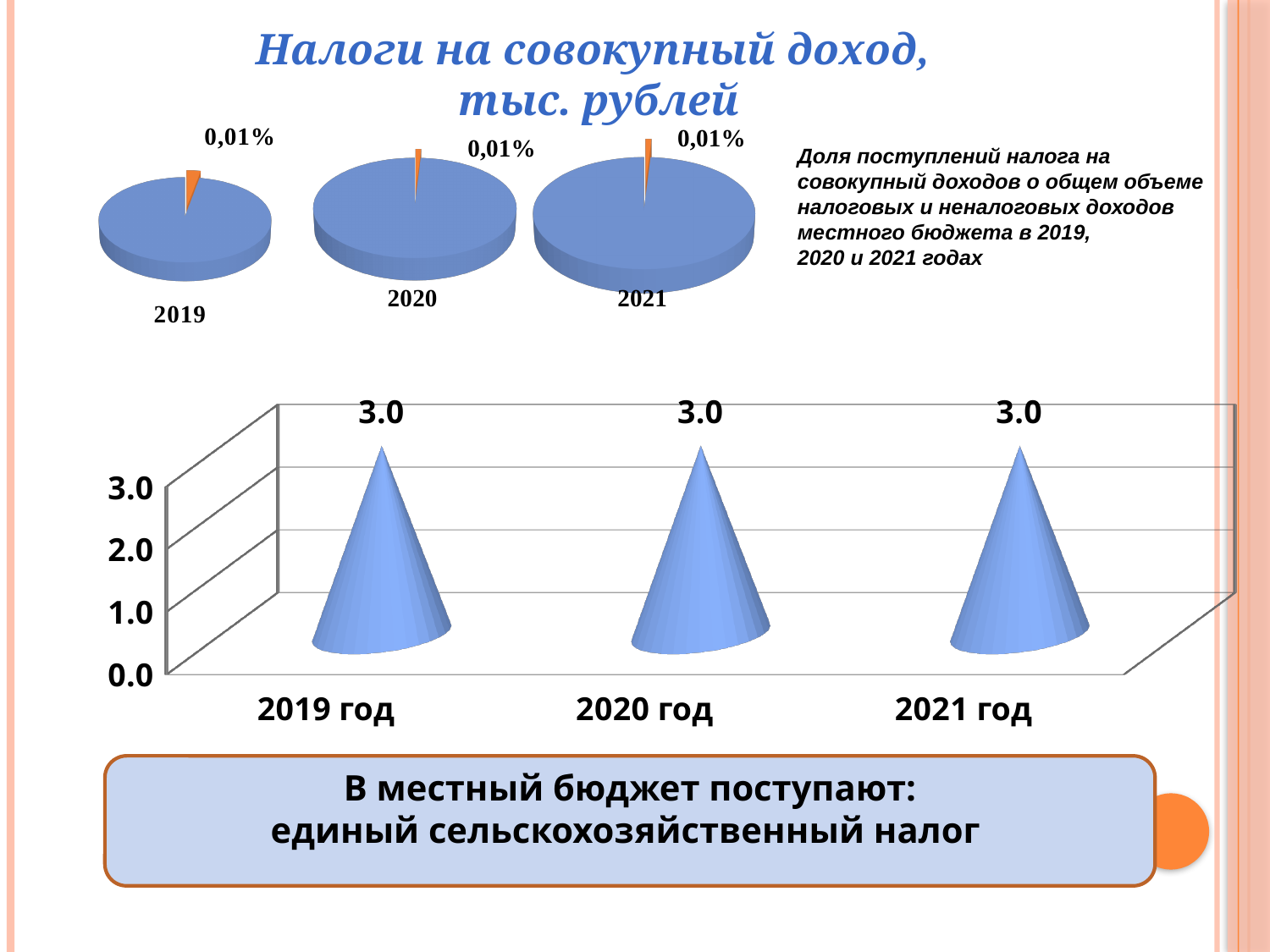
How many categories are shown in the bar chart at the bottom of the slide? 3 In the pie chart labelled 2019 at the top of the slide, what share is shown for the orange slice? 0,01% In the bar chart at the bottom of the slide, what is the value for 2019 год? 3.0 How many pie charts are shown at the top of the slide? 3 In the bar chart at the bottom of the slide, do the values rise, fall or stay the same from 2019 год to 2021 год? stay the same In the bar chart at the bottom of the slide, what is the value for 2021 год? 3.0 In the pie chart labelled 2021 at the top of the slide, what share is shown for the orange slice? 0,01% In the bar chart at the bottom of the slide, what is the value for 2020 год? 3.0 In the bar chart at the bottom of the slide, is the value for 2020 год greater or less than 2.0? greater What kind of chart is the chart at the bottom of the slide with the years 2019 год, 2020 год and 2021 год? bar chart What is the title shown above the pie charts at the top of the slide? Налоги на совокупный доход, тыс. рублей In the bar chart at the bottom of the slide, what is the difference between the values for 2021 год and 2019 год? 0.0